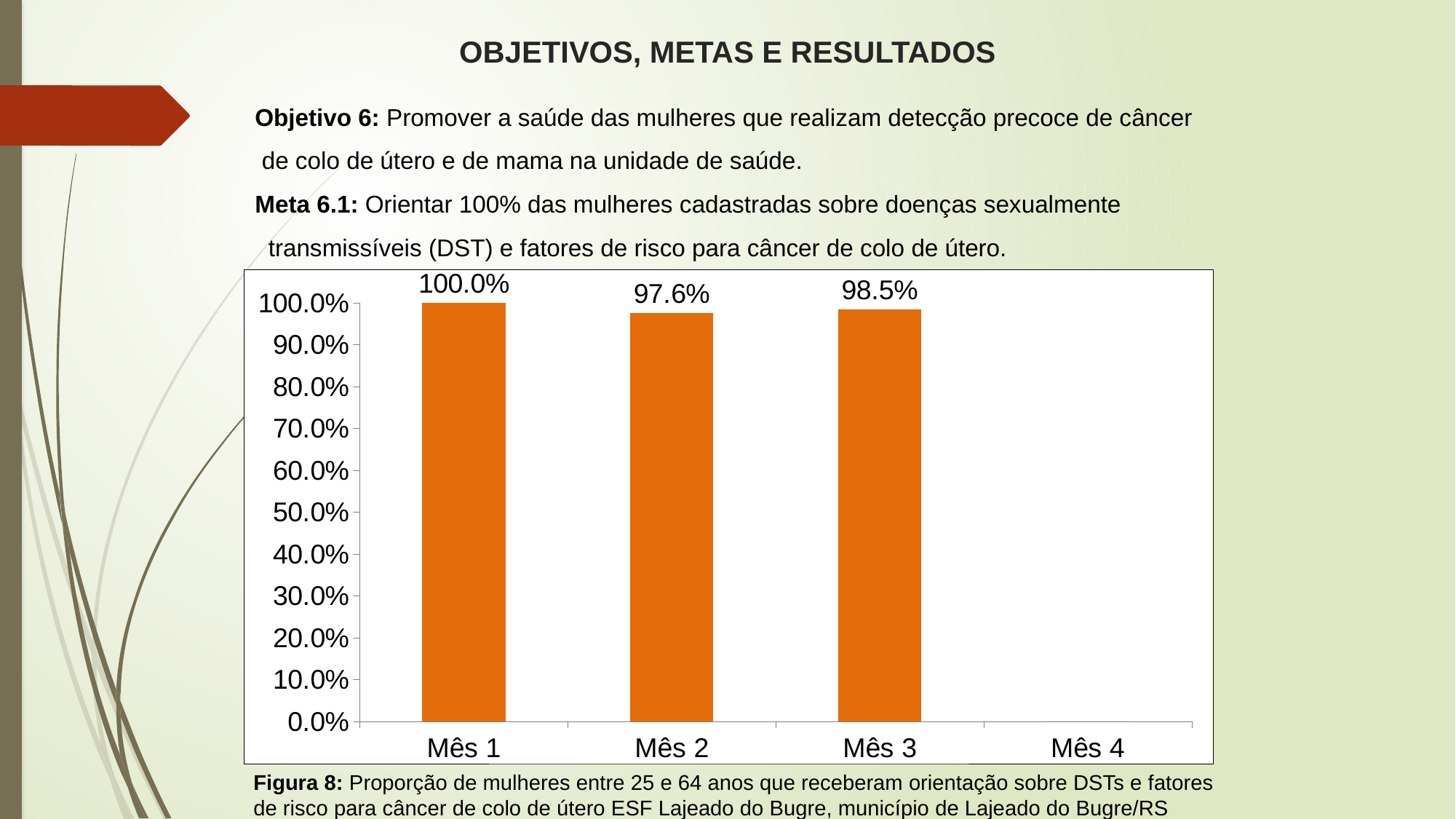
What is the value for Mês 3? 98.5% How many categories are shown on the x axis? 4 Is the value for Mês 2 greater or less than 90.0%? greater What is the difference between the values for Mês 3 and Mês 2? 0.9% Does the value rise or fall from Mês 1 to Mês 2? fall What is the value for Mês 2? 97.6% Which month has the highest value? Mês 1 What is the difference between the values for Mês 1 and Mês 2? 2.4% What is the value for Mês 1? 100.0% What colour are the bars in the chart? orange What kind of chart is shown on the slide? bar chart Which is larger, the value for Mês 2 or the value for Mês 3? Mês 3